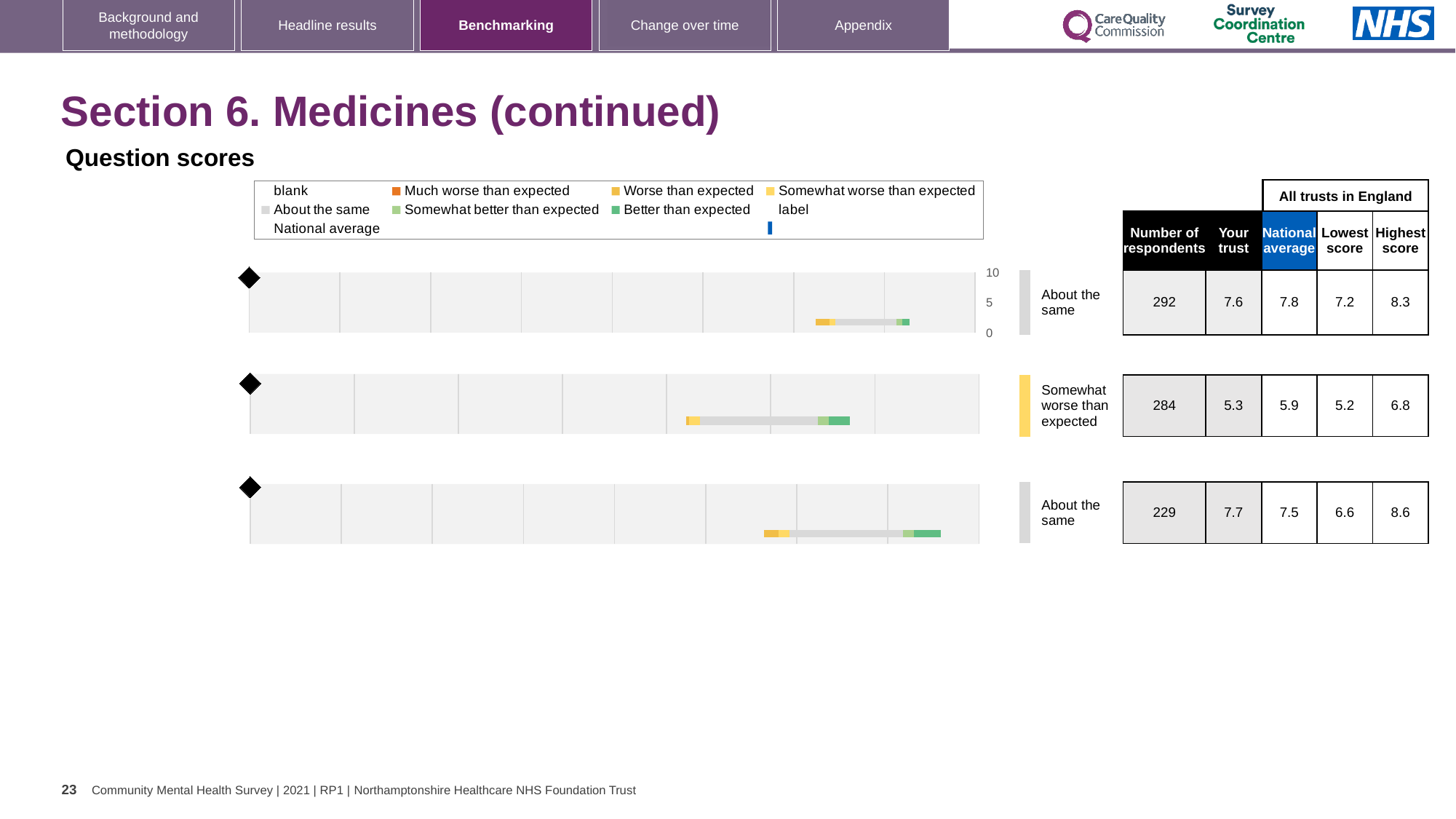
Which of the three charts has the highest 'Your trust' score? the bottom chart Which of the three charts has the lowest number of respondents? the bottom chart What benchmark category label is shown next to the top chart? About the same For the bottom chart, which is larger: the 'Your trust' score or the national average? Your trust For the bottom chart, how many respondents are shown in the table? 229 What benchmark category label is shown next to the middle chart? Somewhat worse than expected For the middle chart, what is the difference between the national average and the 'Your trust' score? 0.6 For the top chart, what is the difference between the highest score and the lowest score in the table? 1.1 What kind of chart is used for the question scores on this slide? bar chart For the middle chart, what is the national average score shown in the table? 5.9 How many question score charts are shown on the slide? 3 For the top chart, what is the 'Your trust' score shown in the table? 7.6